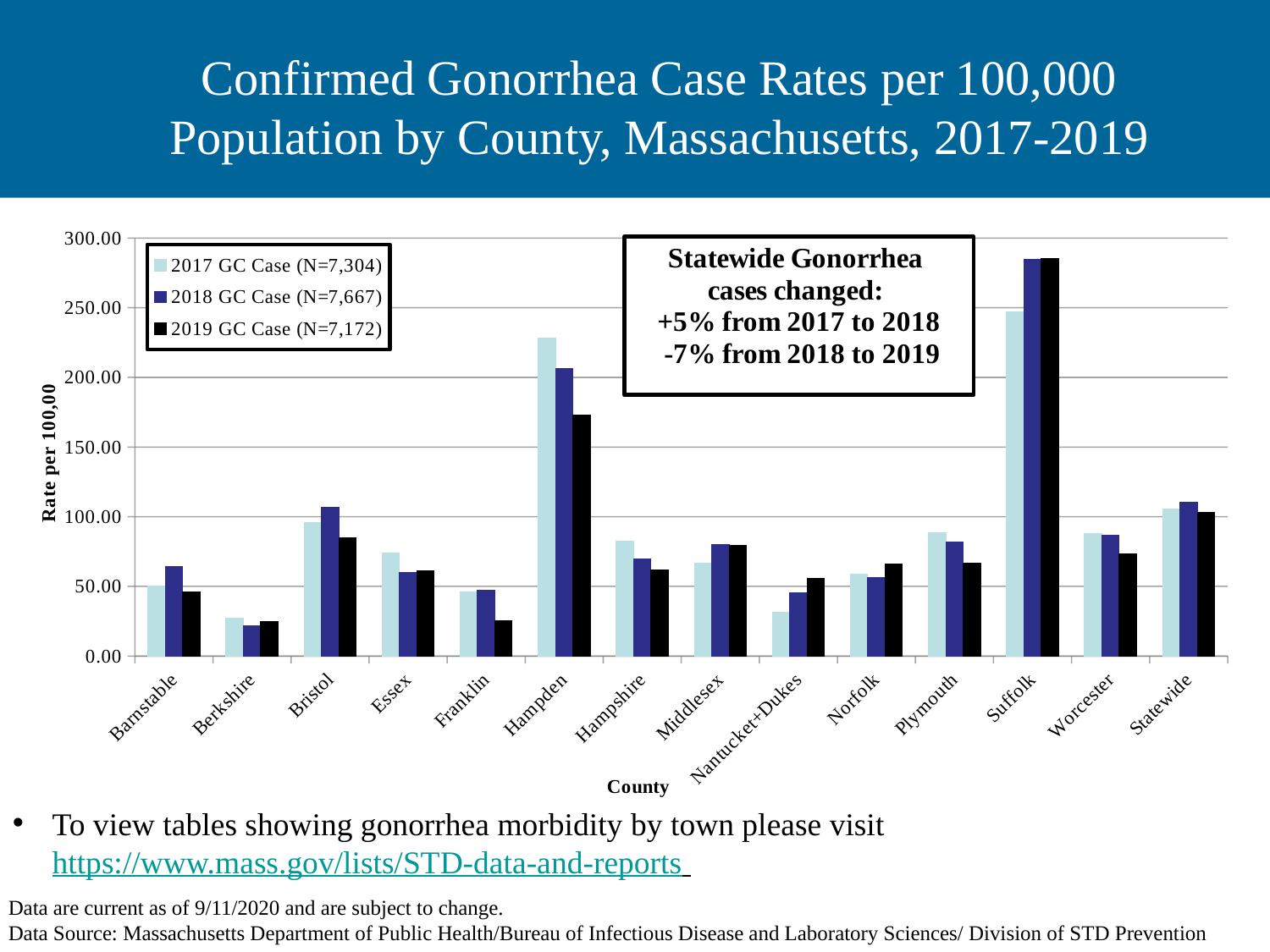
Do the GC case rates for Hampden rise or fall from 2017 to 2019? fall Is the 2019 GC case rate for Suffolk greater or less than 250.00? greater Which county has the highest 2019 GC case rate? Suffolk Is the 2017 GC case rate for Berkshire greater or less than 50.00? less According to the legend, what is the N for the 2018 GC Case series? 7,667 How many series does the legend list? 3 Which is larger, the 2017 or the 2019 GC case rate for Plymouth? 2017 Is the 2017 GC case rate for Hampden greater or less than 200.00? greater Which is larger, the 2017 GC case rate for Bristol or for Essex? Bristol How many counties/categories are shown along the x axis, including Statewide? 14 Which county has the lowest 2018 GC case rate? Berkshire What kind of chart is shown on the slide? bar chart